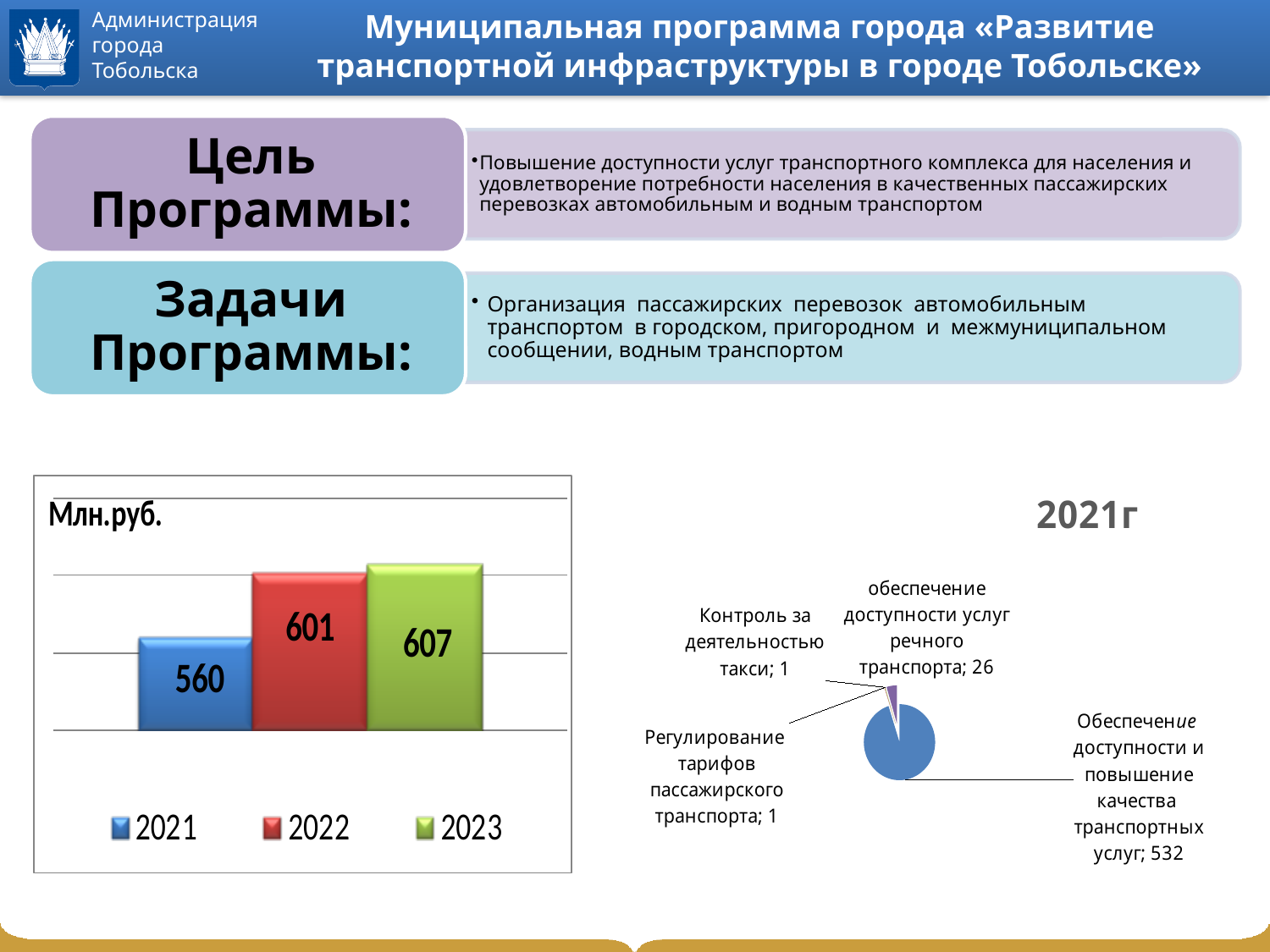
In the bar chart on the left, which year has the lowest value? 2021 In the pie chart titled 2021г, what is the value for «обеспечение доступности услуг речного транспорта»? 26 In the bar chart on the left, which year has the highest value? 2023 In the bar chart on the left, what unit is shown in the chart's label? Млн.руб. In the bar chart on the left, what is the value for 2022? 601 In the pie chart titled 2021г, how many slices are there? 4 In the bar chart on the left, do the values rise or fall from 2021 to 2023? rise In the bar chart on the left, what is the value for 2021? 560 In the pie chart titled 2021г, what is the value for «Обеспечение доступности и повышение качества транспортных услуг»? 532 In the bar chart on the left, what is the difference between the values for 2023 and 2021? 47 In the bar chart on the left, how many entries does the legend list? 3 In the pie chart titled 2021г, what share of the total does «Обеспечение доступности и повышение качества транспортных услуг» represent? 95%